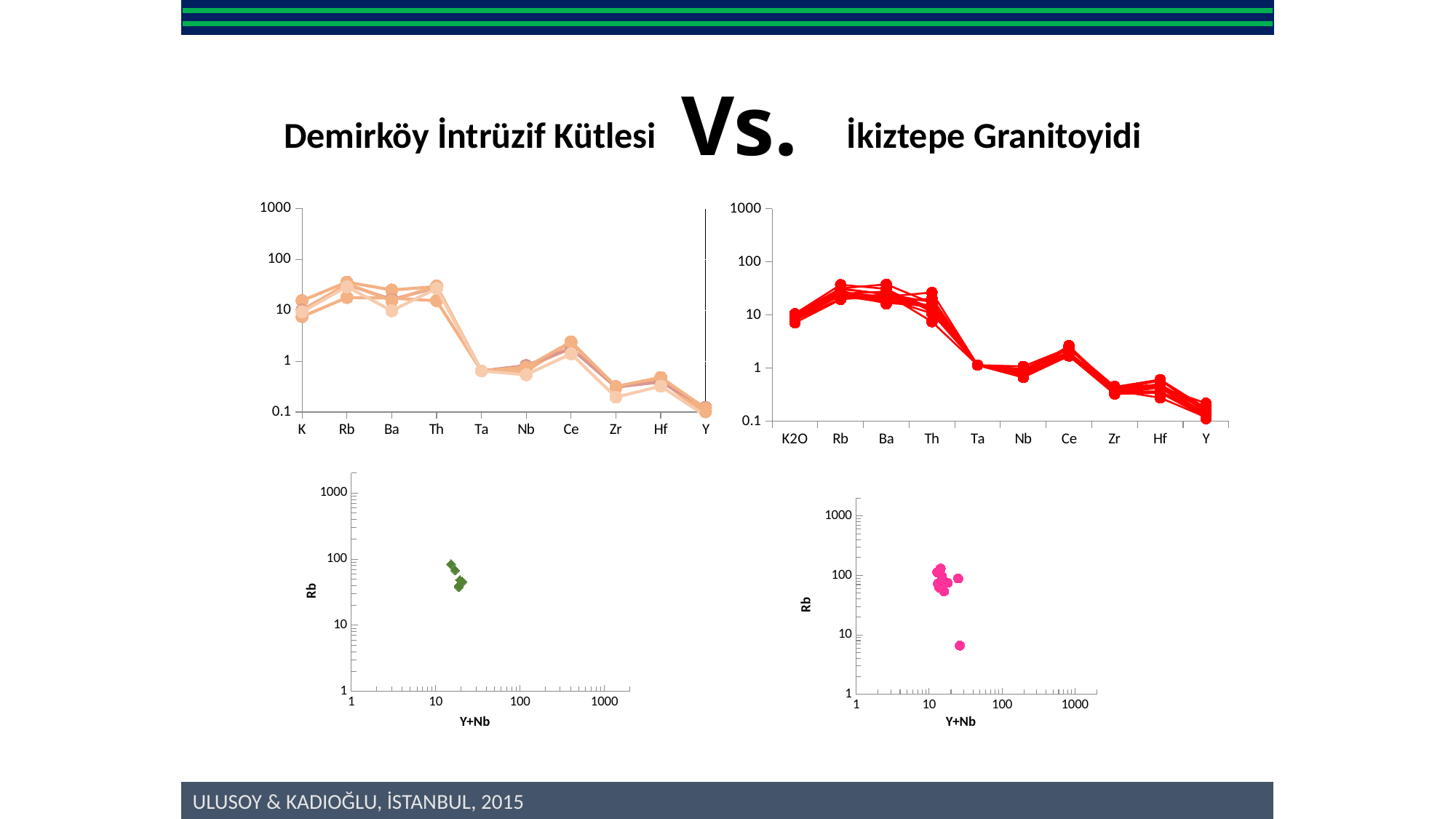
What kind of chart is the bottom-right chart with Rb on the y axis and Y+Nb on the x axis? scatter chart In the top-left line chart, are the values for Ta greater or less than 1? less In the top-right line chart, which has larger values, Ba or Zr? Ba In the top-right line chart, are the values for Ce greater or less than 1? greater What is the x-axis label of the bottom-left scatter chart? Y+Nb What kind of chart is the top-left chart under 'Demirköy İntrüzif Kütlesi'? line chart In the top-left line chart, are the values for Rb greater or less than 10? greater How many categories are shown on the x axis of the top-right line chart? 10 How many categories are shown on the x axis of the top-left line chart? 10 In the top-left line chart, do the values generally rise or fall from K to Y along the x axis? fall